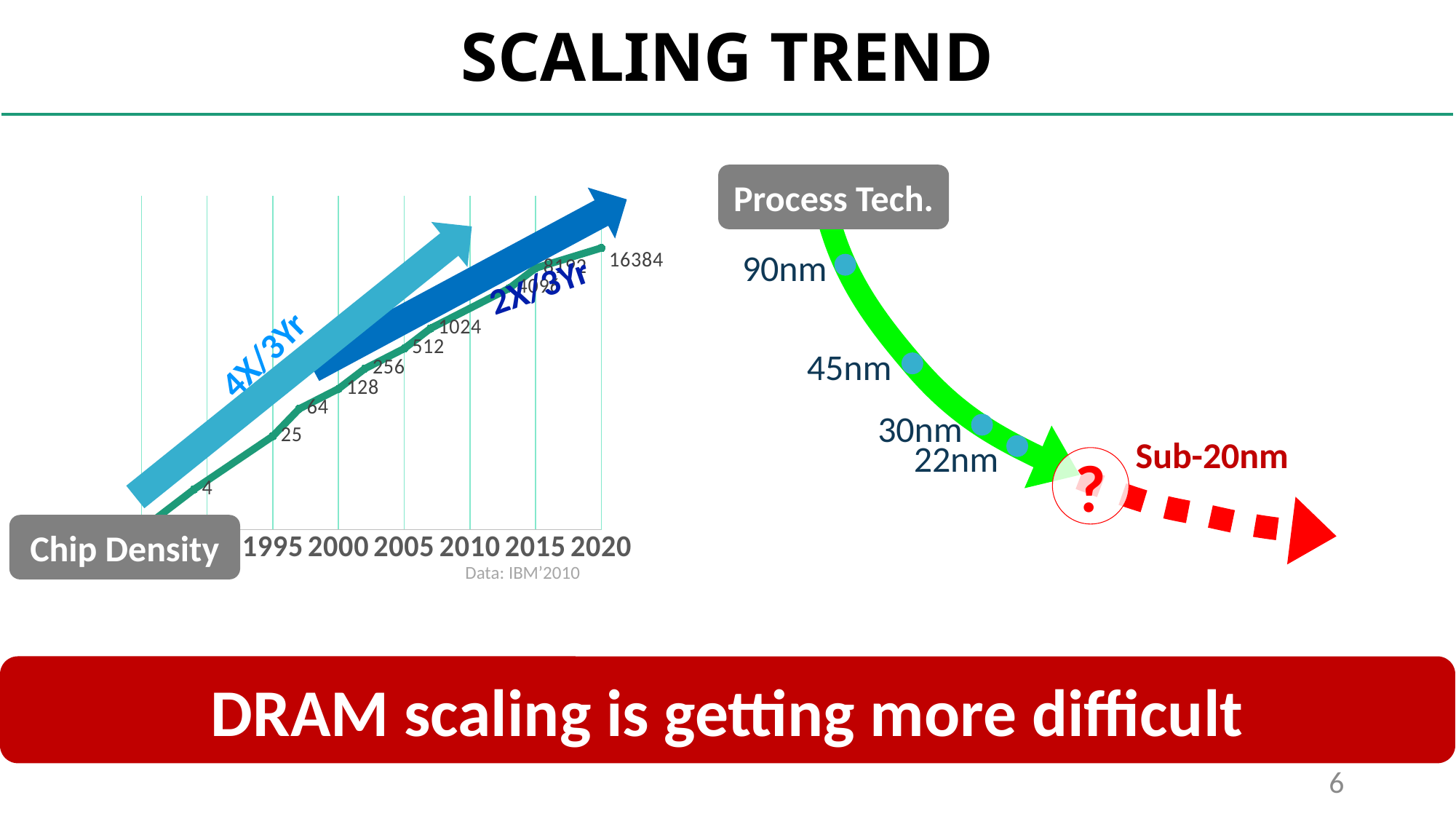
In the Chip Density chart, do the values rise or fall from left to right along the x axis? rise What is the last year label on the x axis of the Chip Density chart? 2020 What kind of chart is the Chip Density chart? line chart In the Chip Density chart, what is the difference between the data labels 16384 and 1024? 15360 What data source is cited below the Chip Density chart? Data: IBM'2010 What is the lowest data label shown on the Chip Density chart? 4 What growth rate is written on the light blue arrow in the Chip Density chart? 4X/3Yr In the Chip Density chart, which is larger, the data label 256 or the data label 128? 256 What is the highest data label shown on the Chip Density chart? 16384 In the Chip Density chart, what is the difference between the data labels 1024 and 512? 512